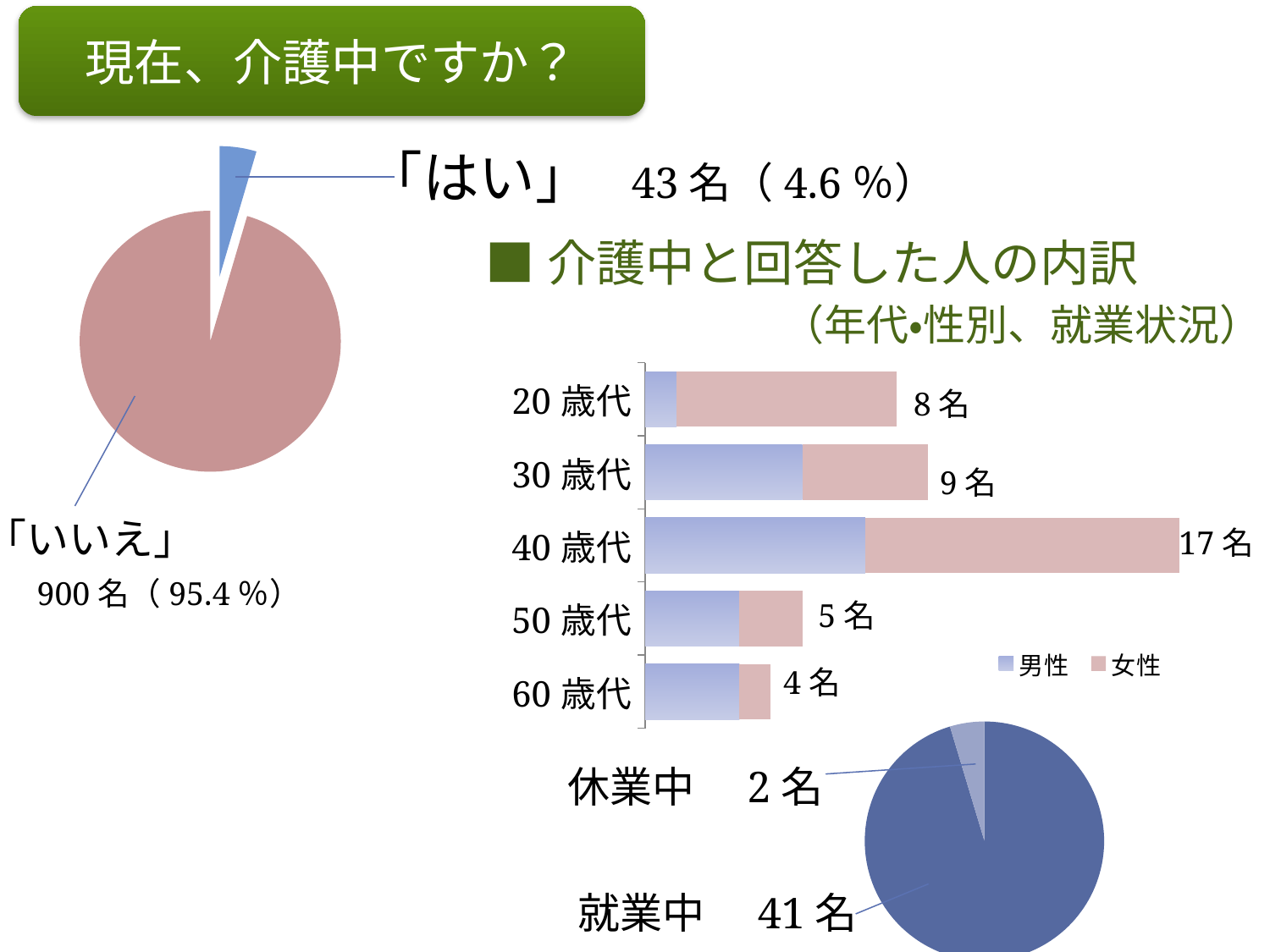
How many series does the legend of the bar chart list? 2 In the top-left pie chart, what percentage share does 「はい」 have? 4.6% In the bar chart by age group, what is the difference between the totals for 40歳代 and 20歳代? 9名 In the bottom-right pie chart, how many people are 就業中? 41名 In the top-left pie chart, how many respondents answered 「はい」? 43名 In the bar chart by age group, which is larger, the total for 50歳代 or 60歳代? 50歳代 How many age groups are shown in the bar chart? 5 In the top-left pie chart, what percentage of respondents answered 「いいえ」? 95.4% In the bar chart by age group, what is the total for 30歳代? 9名 What kind of chart is used to show the breakdown by age group? Bar chart In the bar chart by age group, which age group has the highest total? 40歳代 In the bar chart by age group, which age group has the lowest total? 60歳代